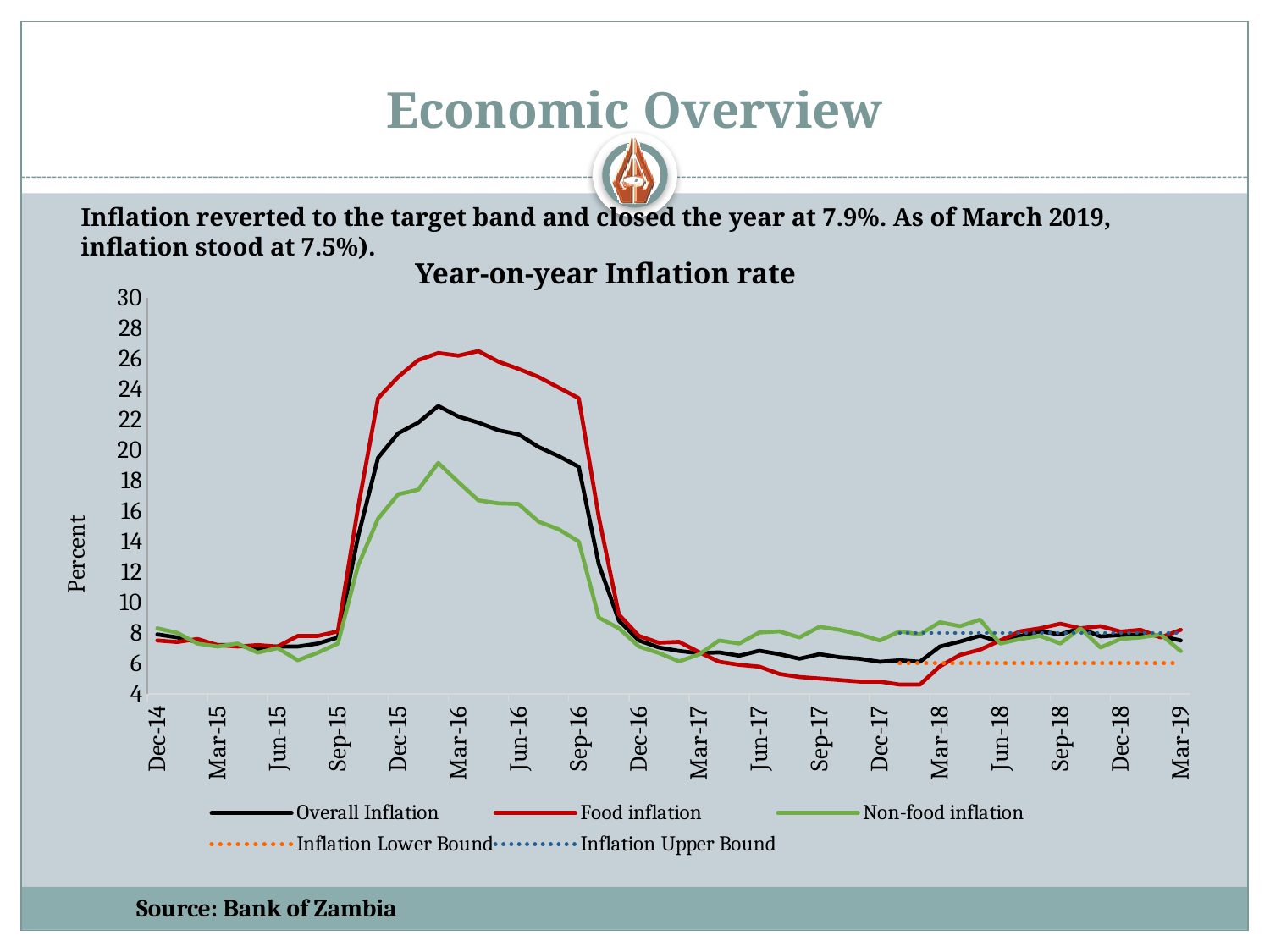
Is the value for Food inflation at Dec-17 greater or less than 6? less What kind of chart is shown on the slide? line chart At Mar-16, which is larger: Food inflation or Overall Inflation? Food inflation What is the label on the vertical axis of the chart? Percent Does Overall Inflation rise or fall between Mar-16 and Mar-17? fall What is the title of the chart? Year-on-year Inflation rate Is the value for Overall Inflation at Mar-16 greater or less than 20? greater Which series has the lowest value around Dec-17? Food inflation Is the value for Food inflation at Mar-16 greater or less than 24? greater Which series reaches the highest peak on the chart? Food inflation At Dec-17, which is larger: Non-food inflation or Food inflation? Non-food inflation How many series does the legend of the Year-on-year Inflation rate chart list? 5